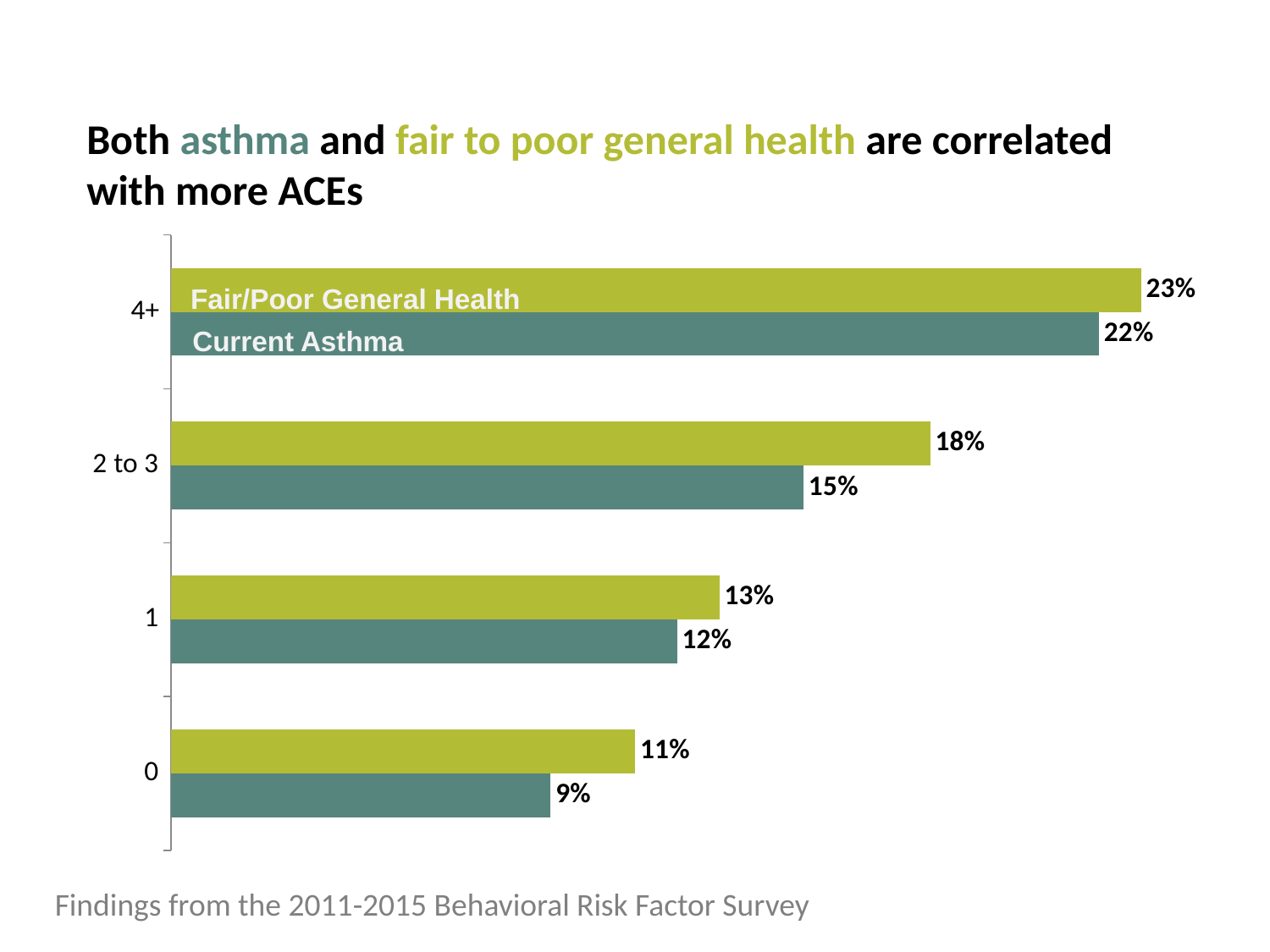
What is the Fair/Poor General Health value for the 4+ ACEs category? 23% Which ACEs category has the highest Current Asthma value? 4+ What is the difference between the Fair/Poor General Health and Current Asthma values for the 2 to 3 ACEs category? 3% Which is larger for the 0 ACEs category: Fair/Poor General Health or Current Asthma? Fair/Poor General Health What is the Fair/Poor General Health value for the 1 ACE category? 13% Do the Current Asthma values rise or fall as the number of ACEs increases from 0 to 4+? Rise What is the Current Asthma value for the 0 ACEs category? 9% What kind of chart is shown on the slide? Bar chart What is the Current Asthma value for the 2 to 3 ACEs category? 15% How many series does the chart show? 2 How many ACEs categories are shown on the chart? 4 Which ACEs category has the lowest Fair/Poor General Health value? 0